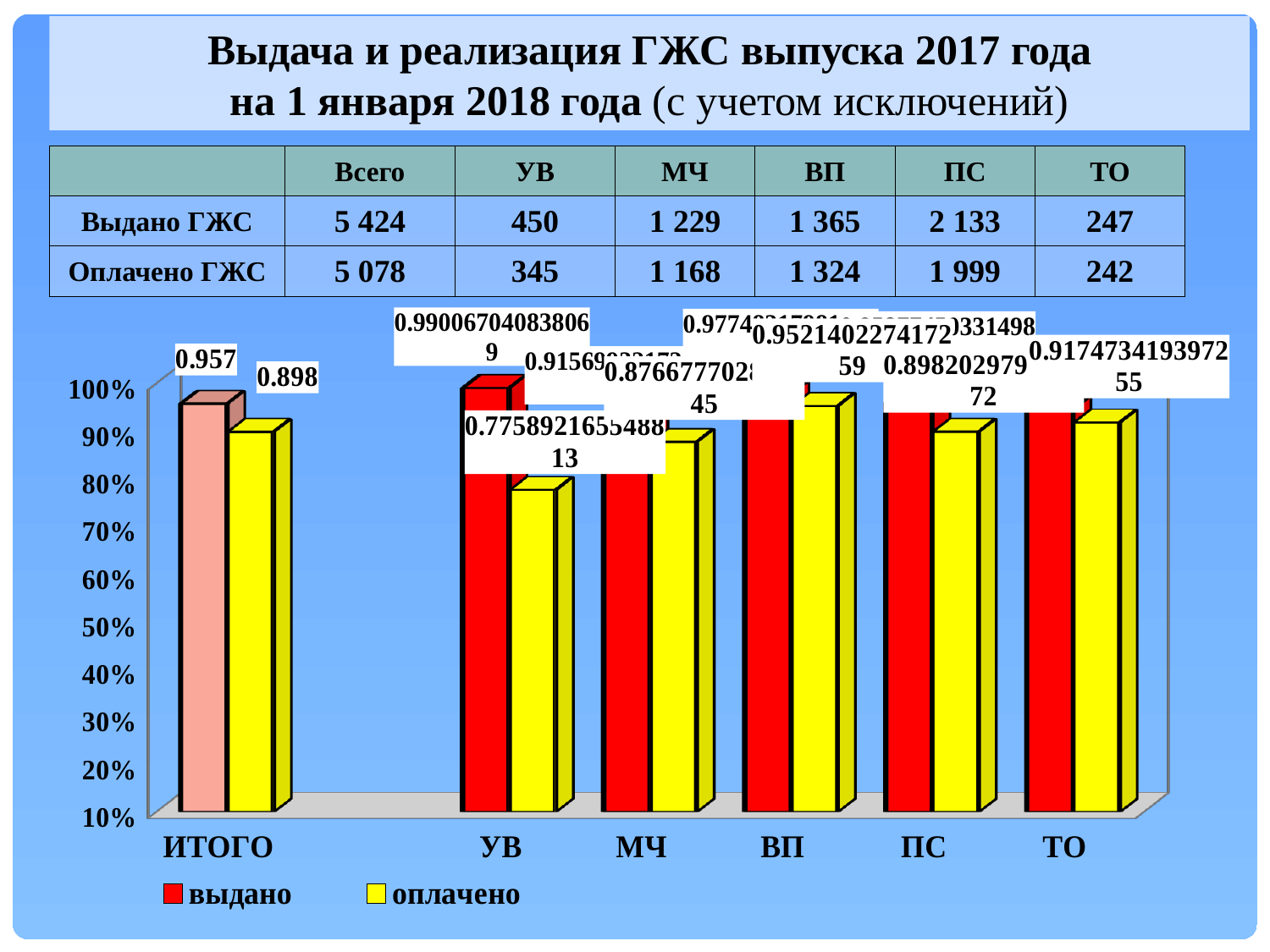
What type of chart is shown on the slide? bar chart For ИТОГО, which is larger: выдано or оплачено? выдано How many categories are shown on the x axis of the chart? 6 How many series does the chart legend list? 2 What is the value of the выдано bar for ИТОГО? 0.957 Is the оплачено value for МЧ greater or less than 80%? greater What is the difference between the выдано and оплачено values for ИТОГО? 0.059 Is the оплачено value for УВ greater or less than 80%? less What is the value of the оплачено bar for ИТОГО? 0.898 Which category has the highest оплачено bar? ВП Which category has the lowest оплачено bar? УВ Is the выдано value for УВ greater or less than 90%? greater